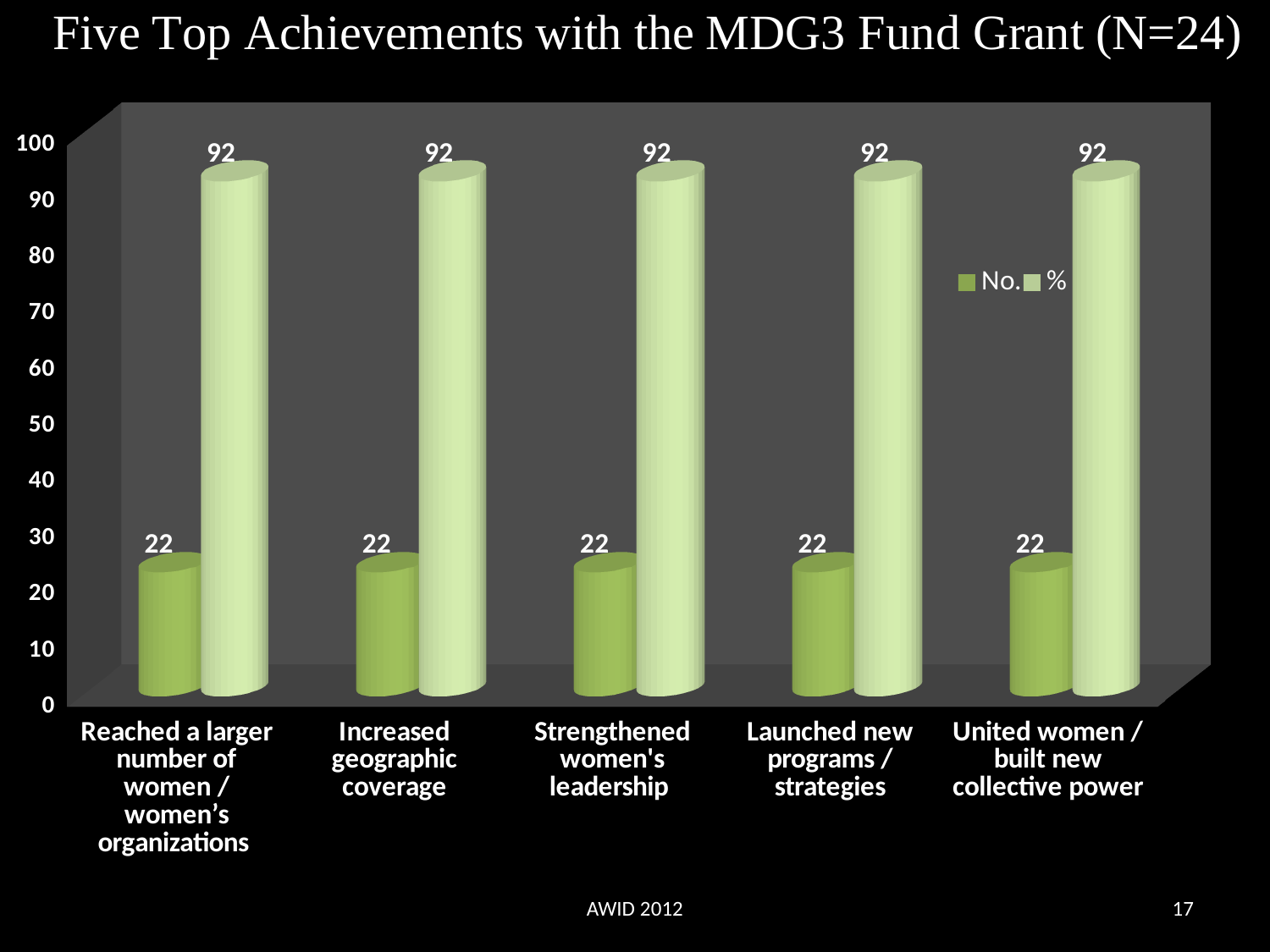
What is the 'No.' value for 'Increased geographic coverage'? 22 For 'Increased geographic coverage', which is larger: the 'No.' value or the '%' value? % Is the '%' value for 'United women / built new collective power' greater or less than 50? greater What is the difference between the '%' value and the 'No.' value for 'Reached a larger number of women / women's organizations'? 70 What kind of chart is shown on the slide? Bar chart Is the 'No.' value for 'Launched new programs / strategies' greater or less than 30? less How many categories are shown on the x axis of the chart? 5 How many series does the legend list? 2 What is the title of the chart? Five Top Achievements with the MDG3 Fund Grant (N=24) What is the 'No.' value for 'United women / built new collective power'? 22 What is the '%' value for 'Launched new programs / strategies'? 92 What is the '%' value for 'Strengthened women's leadership'? 92